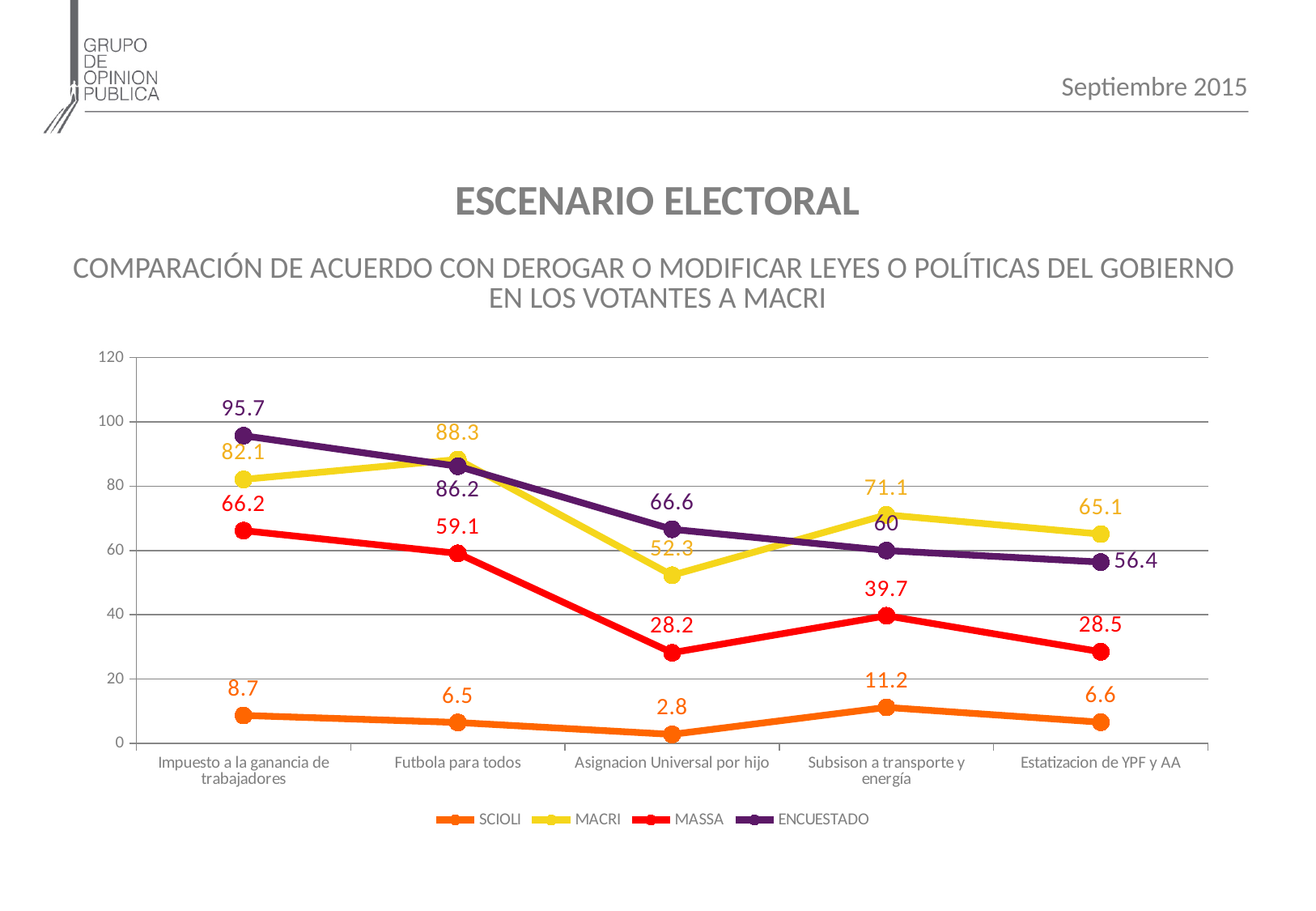
Does the MASSA series rise or fall from Impuesto a la ganancia de trabajadores to Asignacion Universal por hijo? Fall What kind of chart is shown on the slide? Line chart For Subsison a transporte y energía, which is larger: the MACRI value or the ENCUESTADO value? MACRI For which category is the MACRI value lowest? Asignacion Universal por hijo What is the value for MACRI for Futbola para todos? 88.3 How many categories are shown on the x axis? 5 What is the value for ENCUESTADO for Impuesto a la ganancia de trabajadores? 95.7 What is the value for MASSA for Subsison a transporte y energía? 39.7 For which category is the SCIOLI value highest? Subsison a transporte y energía What is the value for SCIOLI for Asignacion Universal por hijo? 2.8 How many series does the legend list? 4 What is the difference between the ENCUESTADO and MACRI values for Impuesto a la ganancia de trabajadores? 13.6